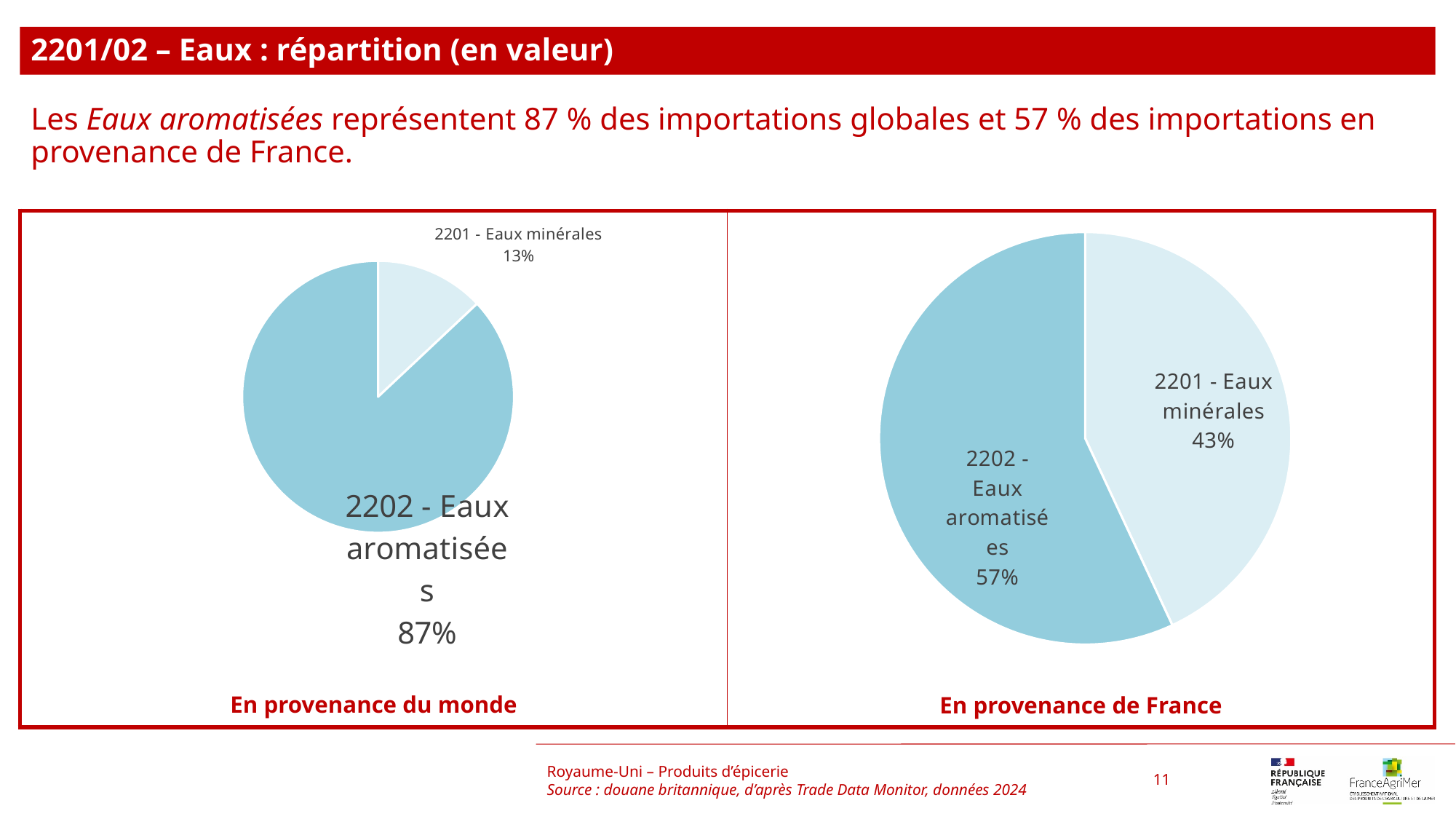
What is the title of the slide? 2201/02 – Eaux : répartition (en valeur) How many slices does the 'En provenance de France' chart have? 2 In the 'En provenance du monde' chart, what is the difference in percentage points between '2202 - Eaux aromatisées' and '2201 - Eaux minérales'? 74 percentage points What kind of chart is the 'En provenance du monde' chart? Pie chart In the 'En provenance du monde' chart, what share does '2201 - Eaux minérales' have? 13% In the 'En provenance de France' chart, what share does '2201 - Eaux minérales' have? 43% In the 'En provenance de France' chart, which category has the smallest slice? 2201 - Eaux minérales In the 'En provenance du monde' chart, which category has the largest slice? 2202 - Eaux aromatisées Which chart shows a larger share for '2201 - Eaux minérales', 'En provenance du monde' or 'En provenance de France'? En provenance de France In the 'En provenance du monde' chart, what share does '2202 - Eaux aromatisées' have? 87% In the 'En provenance de France' chart, what is the difference in percentage points between '2202 - Eaux aromatisées' and '2201 - Eaux minérales'? 14 percentage points